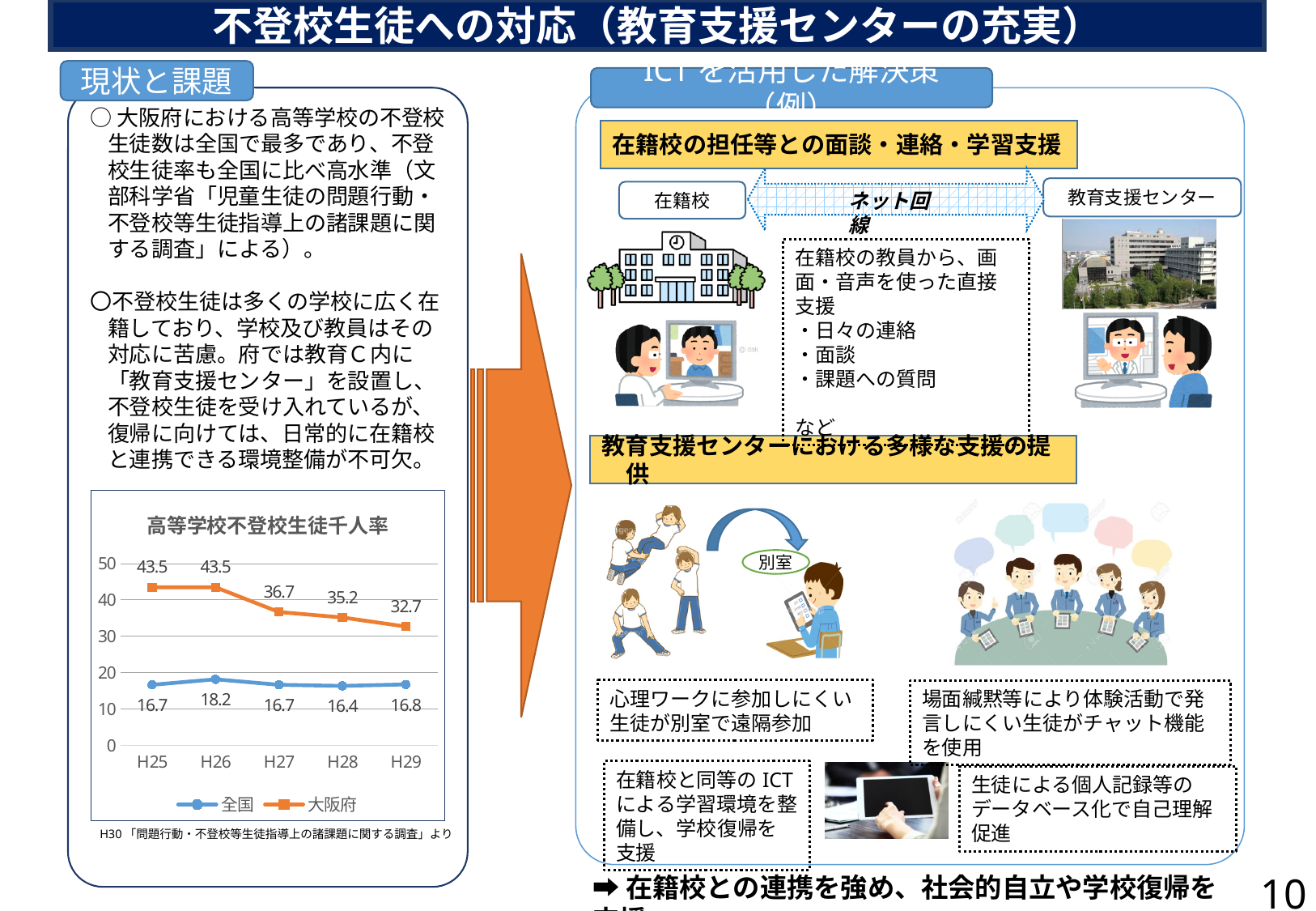
What is the difference between the 大阪府 values in H26 and H27 in the chart 高等学校不登校生徒千人率? 6.8 Which series has the larger value in H25 in the chart 高等学校不登校生徒千人率, 全国 or 大阪府? 大阪府 How many series does the legend of the chart 高等学校不登校生徒千人率 list? 2 How many years are shown on the x axis of the chart 高等学校不登校生徒千人率? 5 What is the value for 大阪府 in H27 in the chart 高等学校不登校生徒千人率? 36.7 What is the value for 全国 in H26 in the chart 高等学校不登校生徒千人率? 18.2 In which year is the 大阪府 value lowest in the chart 高等学校不登校生徒千人率? H29 What kind of chart is 高等学校不登校生徒千人率? Line chart What is the value for 大阪府 in H29 in the chart 高等学校不登校生徒千人率? 32.7 In which year is the 全国 value lowest in the chart 高等学校不登校生徒千人率? H28 What is the difference between the 大阪府 and 全国 values in H29 in the chart 高等学校不登校生徒千人率? 15.9 Does the 大阪府 series rise or fall from H26 to H29 in the chart 高等学校不登校生徒千人率? Fall